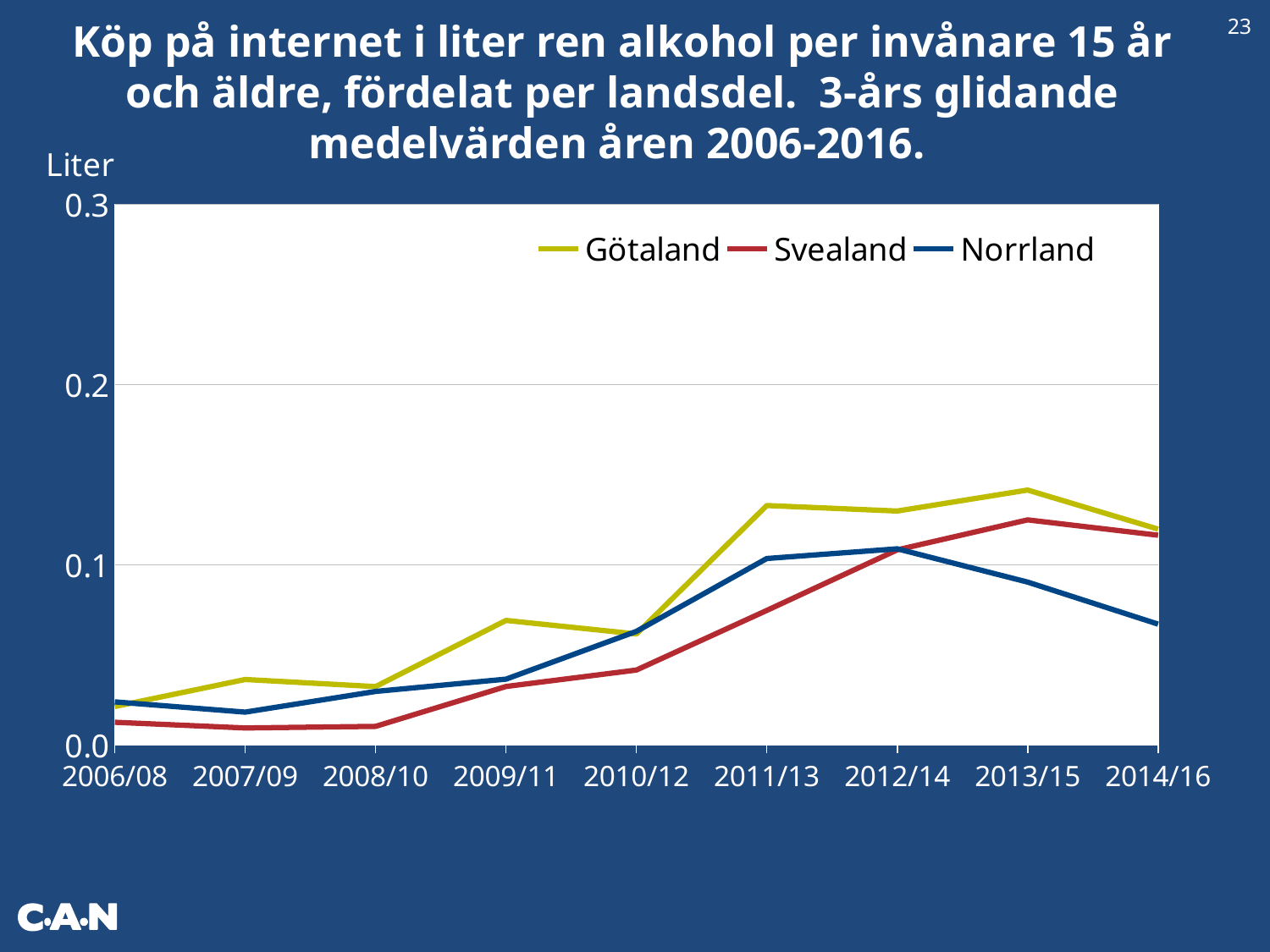
Is the value for Svealand in 2008/10 greater or less than 0.1? less What kind of chart is shown on the slide? line chart Which series does the legend list first? Götaland Which series has the lowest value in 2006/08? Svealand In 2014/16, which is larger: the value for Svealand or the value for Norrland? Svealand Is the value for Norrland in 2014/16 greater or less than 0.1? less Which series has the highest value in 2013/15? Götaland Is the value for Götaland in 2013/15 greater or less than 0.1? greater How many series does the legend list? 3 Does the value for Norrland rise or fall from 2012/14 to 2014/16? fall How many periods are shown along the x axis? 9 What is the label on the y axis? Liter